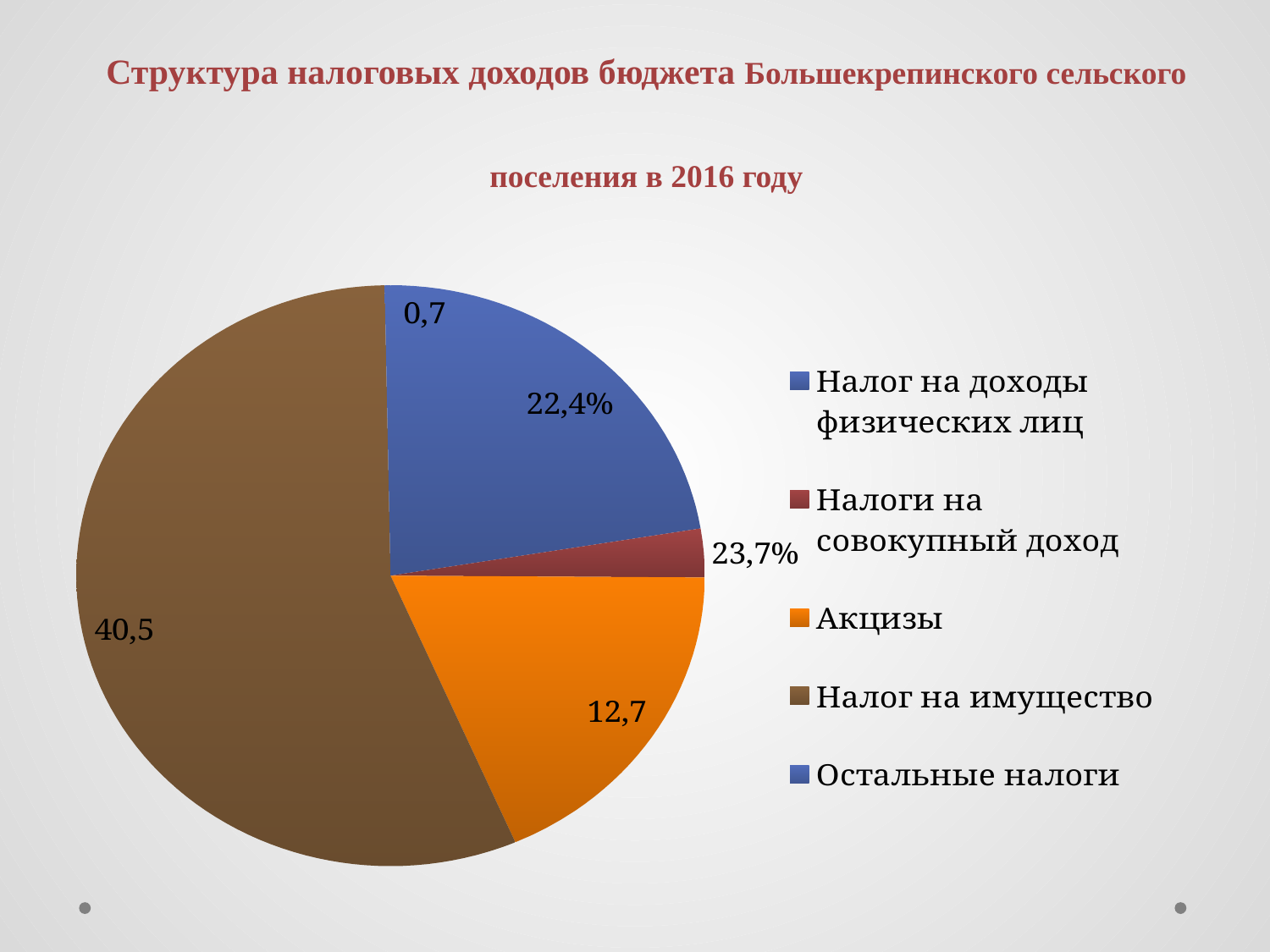
Which category has the largest slice of the pie? Налог на имущество What value is shown for the Акцизы slice? 12,7 What type of chart is shown on the slide? pie chart Which category has the smallest slice of the pie? Остальные налоги What year does the chart title refer to? 2016 What value is shown for the Налог на доходы физических лиц slice? 22,4% What is the difference between the values for Налог на имущество and Акцизы? 27,8 What colour is the Акцизы slice in the pie chart? orange What value is shown for the Налог на имущество slice? 40,5 What value is shown for the Остальные налоги slice? 0,7 Which is larger, the slice for Налог на имущество or the slice for Акцизы? Налог на имущество How many categories does the pie chart have? 5